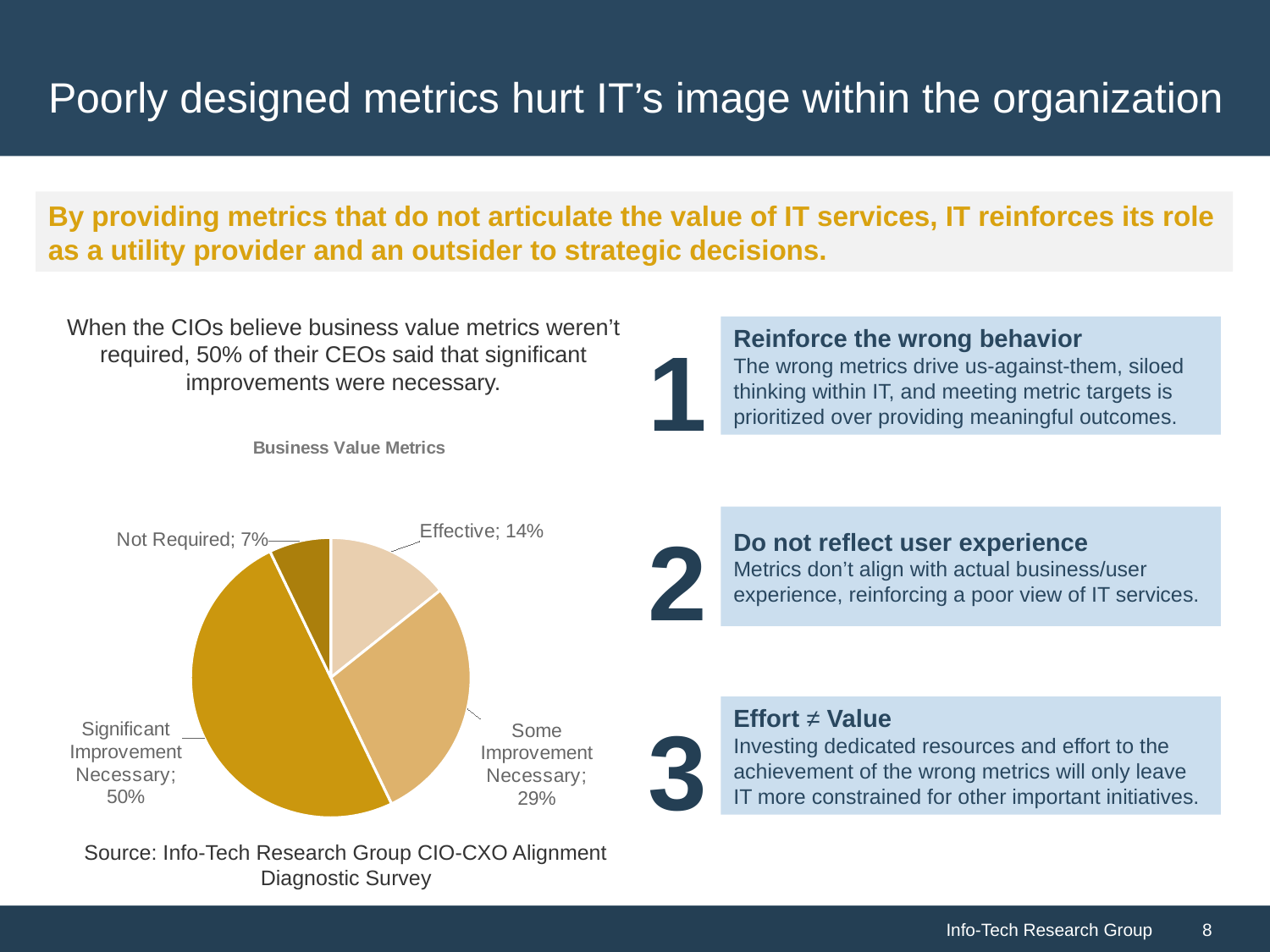
Which slice of the pie is the largest? Significant Improvement Necessary What percentage of the pie is labelled "Some Improvement Necessary"? 29% What percentage of the pie is labelled "Not Required"? 7% What is the combined share of the "Effective" and "Not Required" slices? 21% Which slice of the pie is the smallest? Not Required Which is larger, the "Effective" slice or the "Not Required" slice? Effective What percentage of the pie is labelled "Effective"? 14% What is the difference in percentage points between "Significant Improvement Necessary" and "Some Improvement Necessary"? 21 What percentage of the pie is labelled "Significant Improvement Necessary"? 50% What type of chart is shown on the slide? pie chart How many slices does the pie chart have? 4 What is the title of the chart? Business Value Metrics